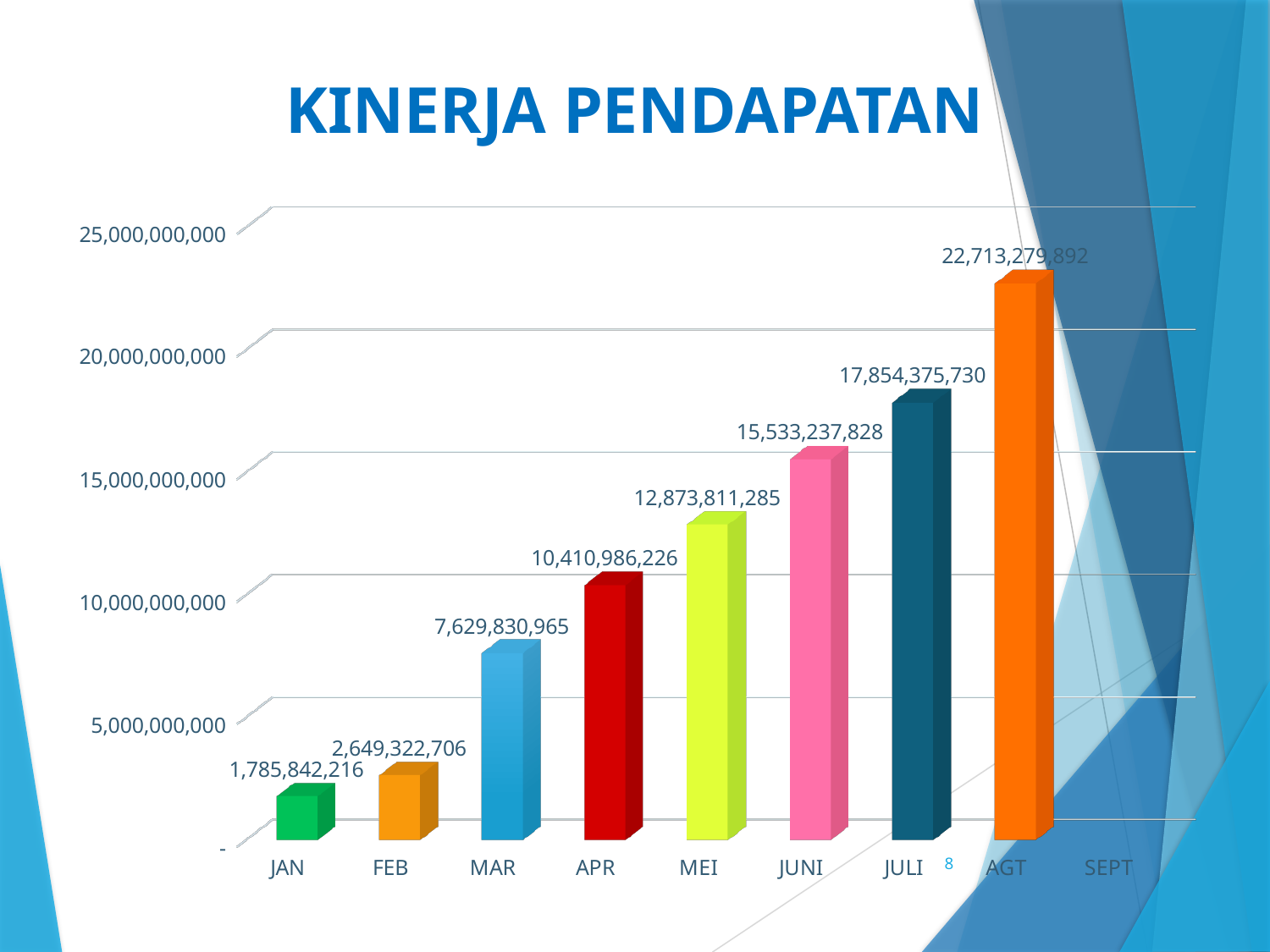
Which is larger, the value for MEI or the value for APR? MEI What is the value for MAR? 7,629,830,965 What kind of chart is shown on the slide? bar chart Do the values rise or fall from JAN to AGT? rise What is the difference between the values for AGT and JULI? 4,858,904,162 How many bars are plotted in the chart? 8 What is the difference between the values for FEB and JAN? 863,480,490 What is the value for JAN? 1,785,842,216 Which month has the highest value? AGT Is the value for MEI greater or less than 15,000,000,000? less What is the value for JUNI? 15,533,237,828 Which month with a bar has the lowest value? JAN